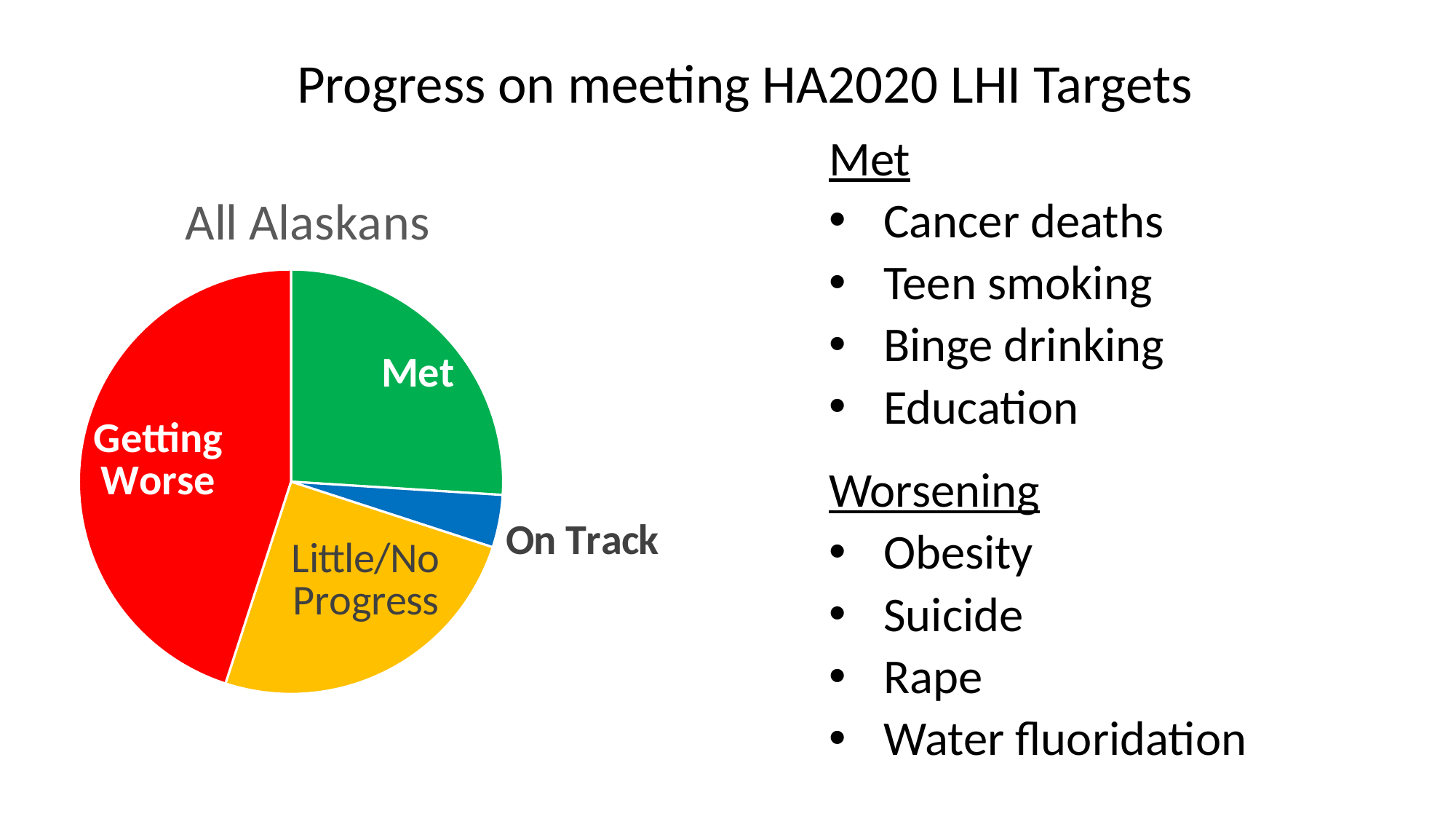
Which slice of the pie chart is the largest? Getting Worse What is the title of the pie chart? All Alaskans Which slice of the pie chart is the smallest? On Track Which slice is larger in the pie chart, Little/No Progress or On Track? Little/No Progress Which slice of the pie chart is coloured blue? On Track Which slice is larger in the pie chart, Getting Worse or Met? Getting Worse What kind of chart is shown on the slide? Pie chart Which slice is larger in the pie chart, Getting Worse or Little/No Progress? Getting Worse How many slices does the pie chart have? 4 What colour is the Getting Worse slice in the pie chart? Red